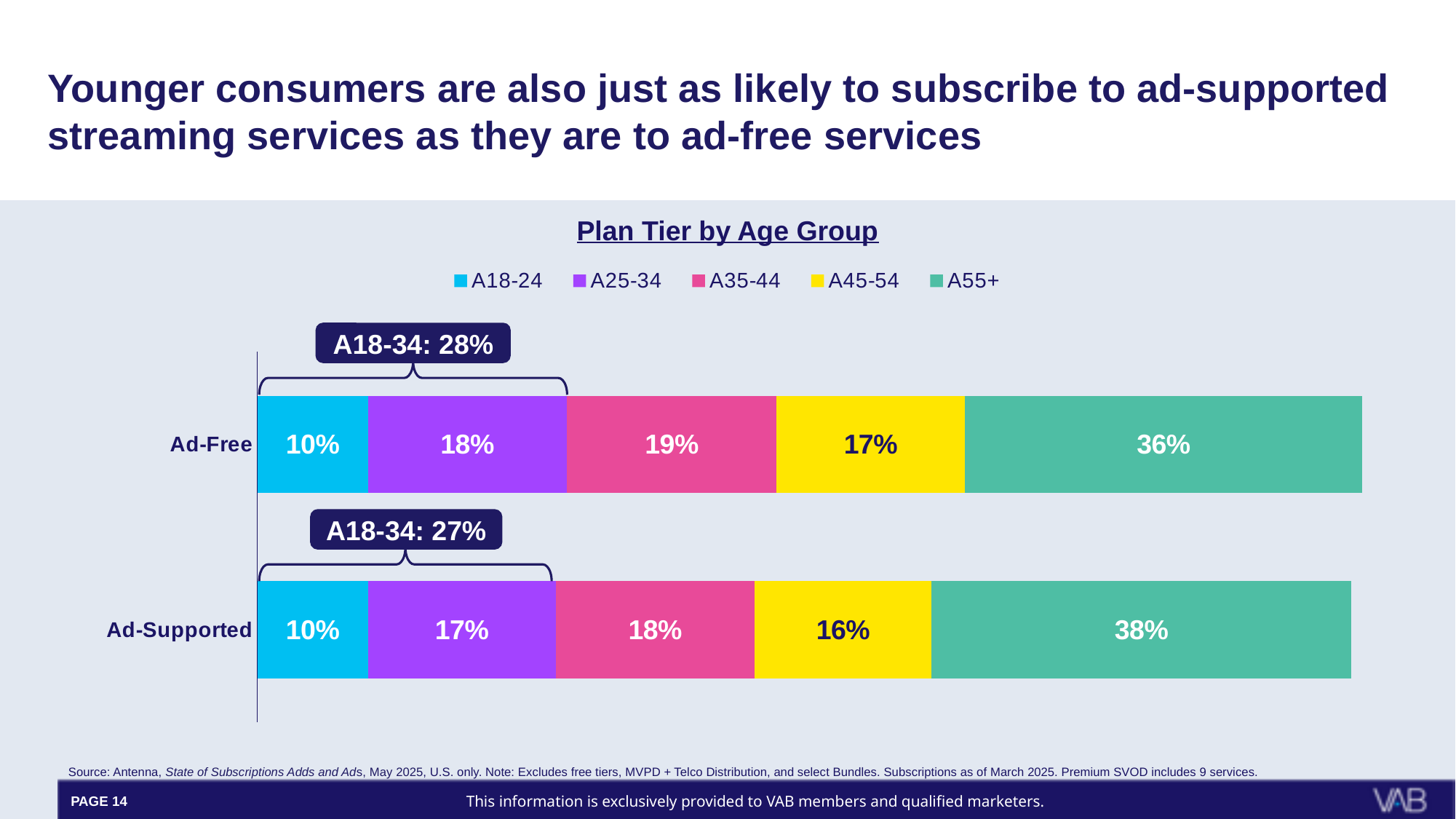
What is the value for A55+ in the Ad-Free bar? 36% Which age group has the largest share of the Ad-Supported bar? A55+ How many age-group series does the legend list? 5 What is the value for A45-54 in the Ad-Free bar? 17% What is the difference between the A55+ values for Ad-Supported and Ad-Free? 2% Which age group has the smallest share of the Ad-Free bar? A18-24 What is the combined A18-34 value shown for the Ad-Supported bar? 27% How many plan tiers (bars) are shown in the chart? 2 Is the A35-44 value larger for Ad-Free or Ad-Supported? Ad-Free What is the value for A35-44 in the Ad-Supported bar? 18% What kind of chart is shown on the slide? Stacked bar chart What is the value for A25-34 in the Ad-Supported bar? 17%